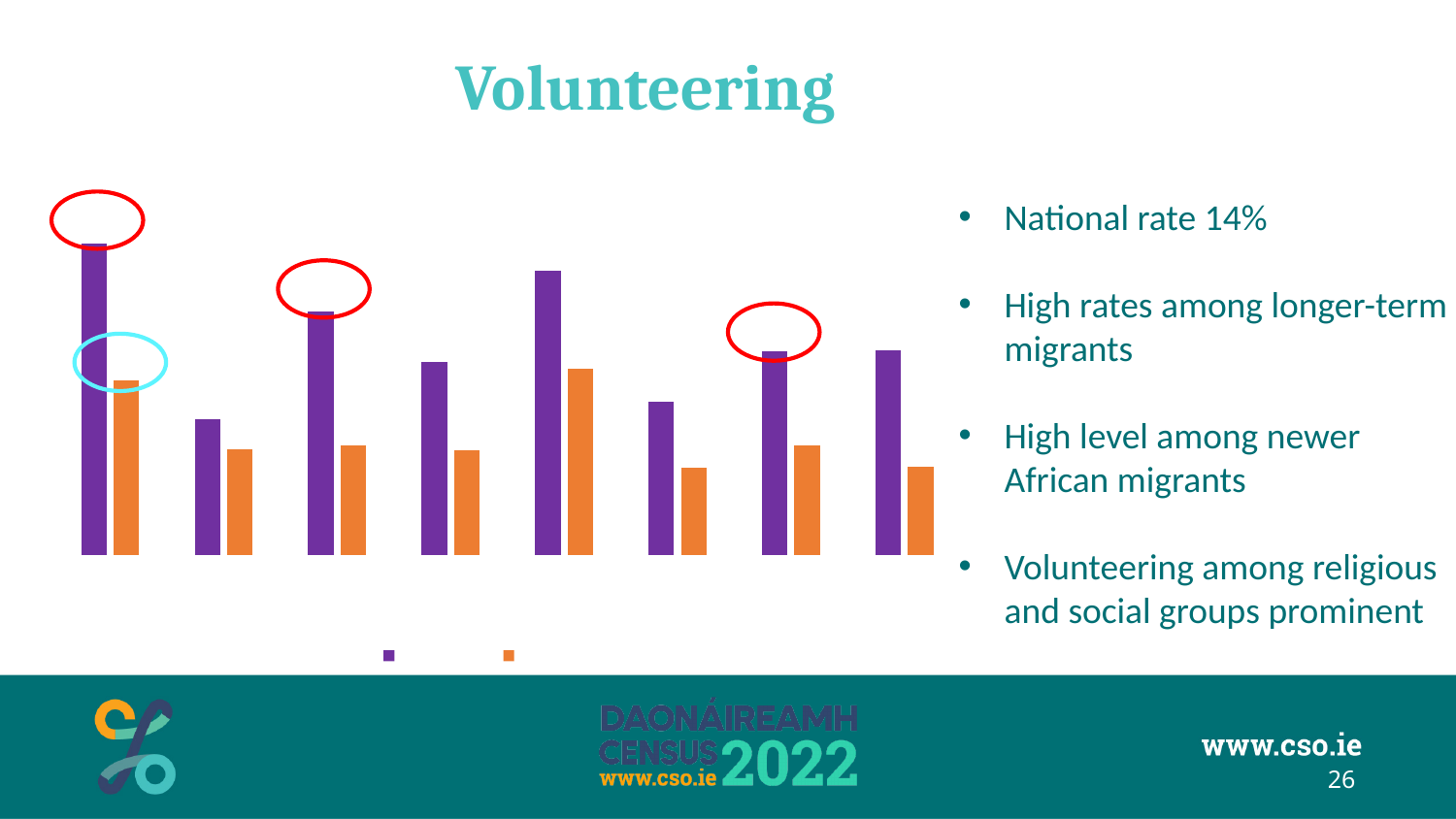
What two colours are used for the bars in the chart? Purple and orange Which group of bars has the tallest purple bar? The first (leftmost) group Is the purple bar taller than the orange bar in every group? Yes Which is taller, the purple bar in the third group or the purple bar in the fifth group? The purple bar in the fifth group How many series does the chart's legend list? 2 Which group of bars has the shortest purple bar? The second group from the left What kind of chart is shown on the slide? Bar chart How many groups of bars are plotted in the chart? 8 In the leftmost group, which bar is taller, the purple one or the orange one? The purple one How many red circles are drawn over the chart? 3